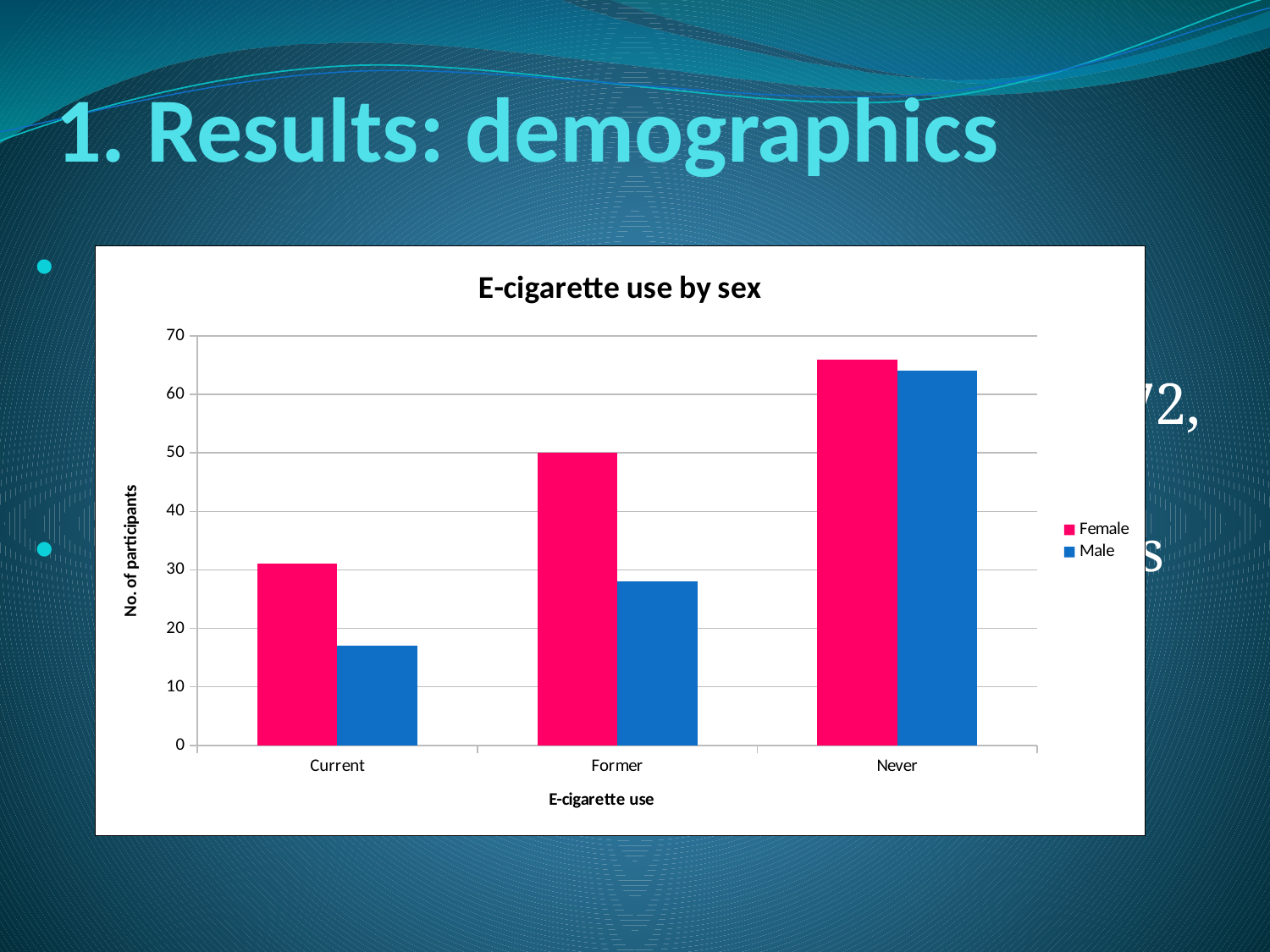
In the Former category, which series has the larger value, Female or Male? Female Is the value for Female participants in the Current category greater or less than 30? greater Which e-cigarette use category has the lowest number of male participants? Current How many e-cigarette use categories are shown on the x axis? 3 How many series does the legend list? 2 Is the value for Female participants in the Never category greater or less than 60? greater What is the title of the chart? E-cigarette use by sex Which e-cigarette use category has the highest number of female participants? Never What is the label of the y axis? No. of participants Is the value for Male participants in the Former category greater or less than 30? less What kind of chart is shown on the slide? bar chart